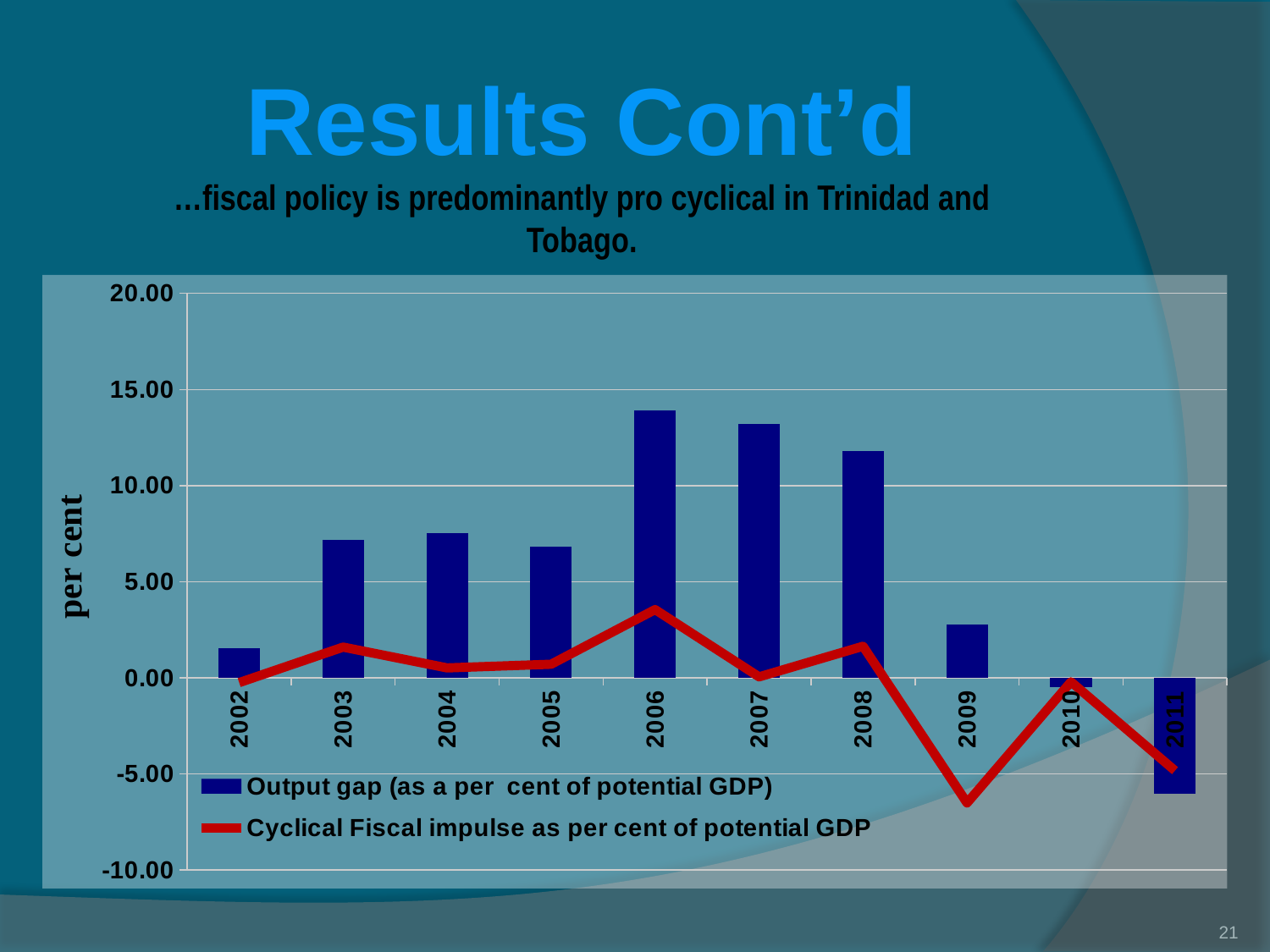
Which year has the lowest value on the cyclical fiscal impulse line? 2009 Is the cyclical fiscal impulse value for 2009 greater or less than -5.00? less Is the output gap bar for 2009 greater or less than 5.00? less How many years are shown on the x axis? 10 What is the label on the vertical axis? per cent Is the output gap bar for 2006 greater or less than 10.00? greater What kind of chart is this? Combined bar and line chart How many series does the legend list? 2 Which year has the highest value on the cyclical fiscal impulse line? 2006 Which year has the lowest output gap bar? 2011 Which year has the larger output gap bar, 2007 or 2008? 2007 Which year has the highest output gap bar? 2006